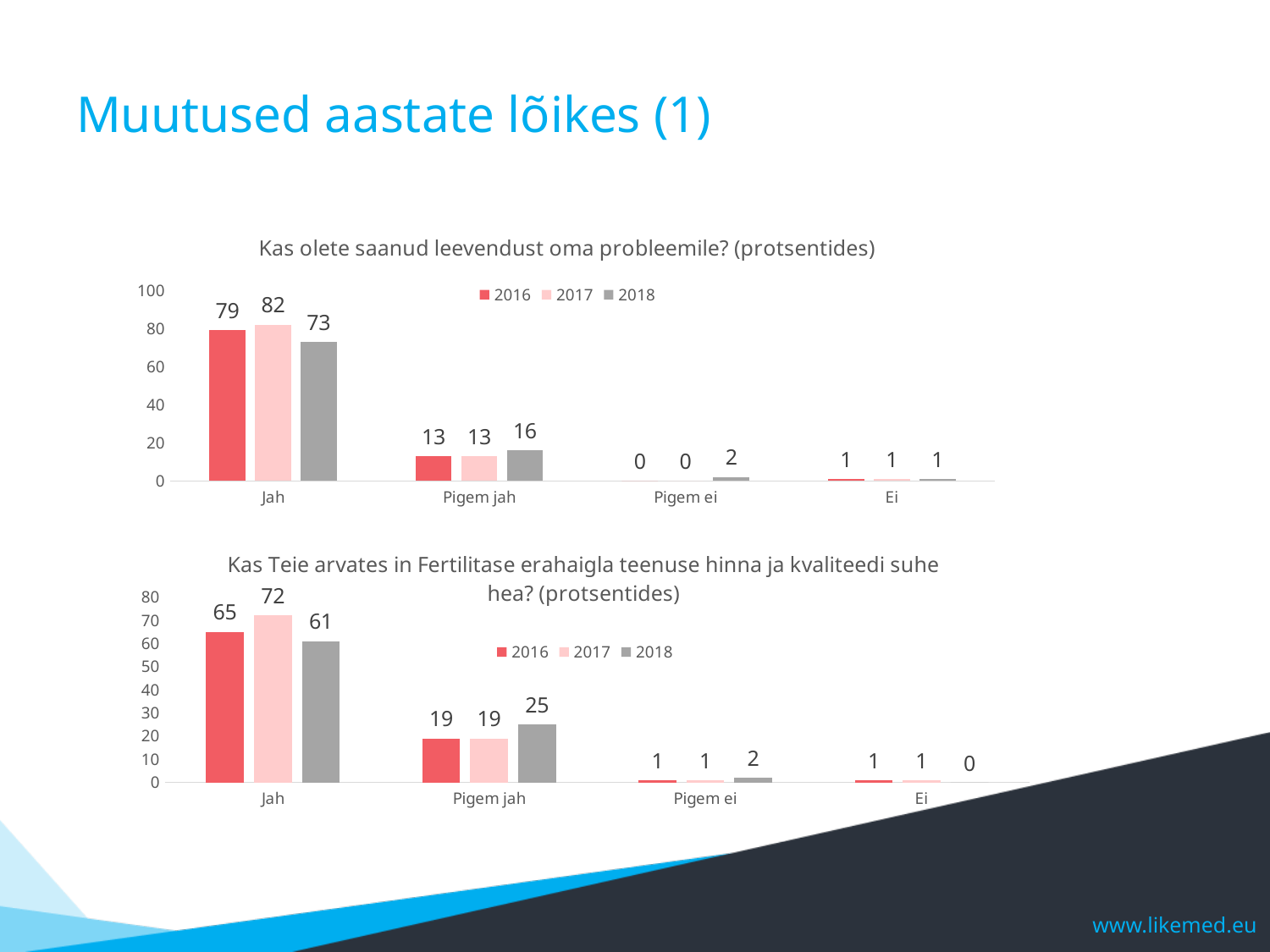
In the top chart 'Kas olete saanud leevendust oma probleemile?', which year has the highest value for 'Jah'? 2017 In the top chart 'Kas olete saanud leevendust oma probleemile?', how many categories are shown on the x axis? 4 In the bottom chart 'Kas Teie arvates in Fertilitase erahaigla teenuse hinna ja kvaliteedi suhe hea?', what is the difference between the 2018 and 2016 values for 'Pigem jah'? 6 In the top chart 'Kas olete saanud leevendust oma probleemile?', how many series does the legend list? 3 In the bottom chart 'Kas Teie arvates in Fertilitase erahaigla teenuse hinna ja kvaliteedi suhe hea?', what is the value for 'Jah' in 2016? 65 What kind of chart is the top chart 'Kas olete saanud leevendust oma probleemile?'? bar chart In the top chart 'Kas olete saanud leevendust oma probleemile?', what is the value for 'Pigem jah' in 2018? 16 In the bottom chart 'Kas Teie arvates in Fertilitase erahaigla teenuse hinna ja kvaliteedi suhe hea?', is the 2017 value for 'Jah' larger or smaller than the 2018 value for 'Jah'? larger In the top chart 'Kas olete saanud leevendust oma probleemile?', what is the value for 'Jah' in 2017? 82 In the bottom chart 'Kas Teie arvates in Fertilitase erahaigla teenuse hinna ja kvaliteedi suhe hea?', what is the value for 'Pigem jah' in 2018? 25 In the top chart 'Kas olete saanud leevendust oma probleemile?', what is the difference between the 2017 and 2018 values for 'Jah'? 9 In the bottom chart 'Kas Teie arvates in Fertilitase erahaigla teenuse hinna ja kvaliteedi suhe hea?', which category has the lowest value in 2018? Ei